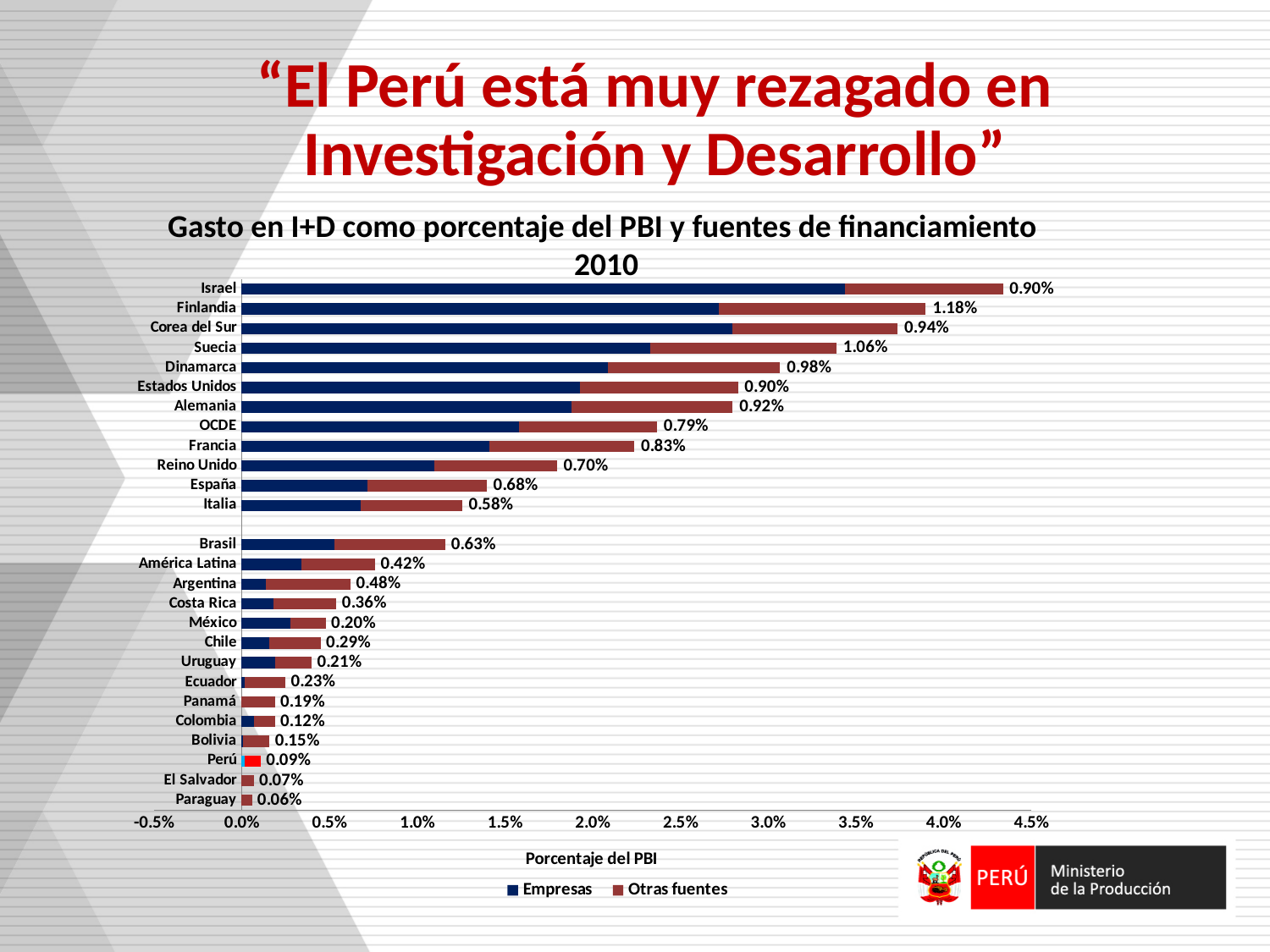
What is the title of the x axis? Porcentaje del PBI What value is labelled on the bar for Perú? 0.09% What are the two series named in the legend? Empresas and Otras fuentes How many series does the legend list? 2 Which country has the lowest labelled value on its bar? Paraguay What value is labelled on the bar for Brasil? 0.63% What kind of chart is shown on the slide? bar chart Which country has the highest labelled value on its bar? Finlandia Is the total bar length for Israel greater or less than 4.0%? greater What value is labelled on the bar for Finlandia? 1.18% What is the difference between the labelled values for Finlandia and Perú? 1.09% Which has the larger labelled value, Suecia or Dinamarca? Suecia